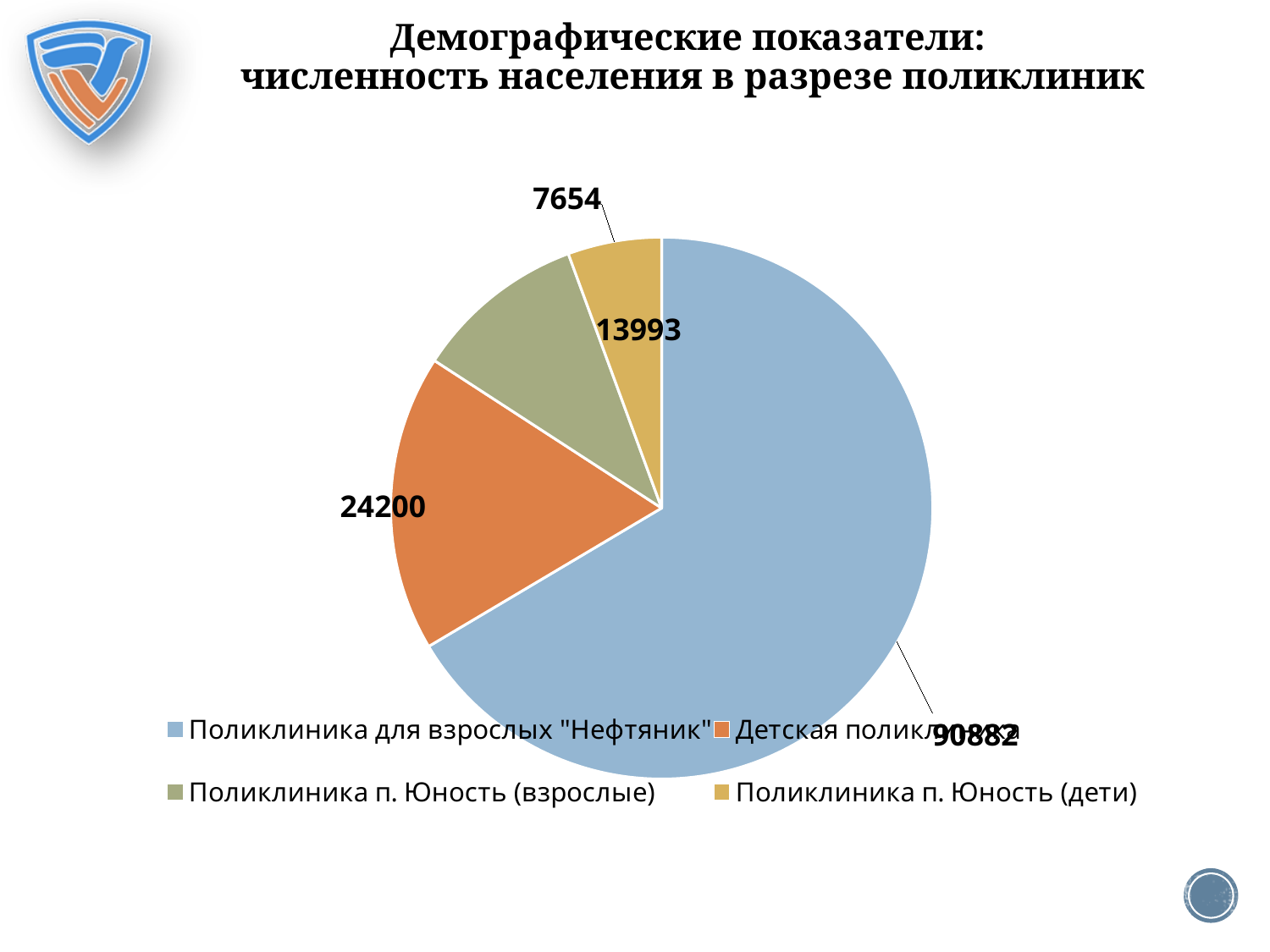
What is the value for Поликлиника п. Юность (взрослые)? 13993 What colour is the slice for Поликлиника п. Юность (дети)? yellow What is the value for Поликлиника для взрослых "Нефтяник"? 90882 Which is larger: Поликлиника п. Юность (взрослые) or Поликлиника п. Юность (дети)? Поликлиника п. Юность (взрослые) What is the value of the orange slice? 24200 What is the difference between Поликлиника п. Юность (взрослые) and Поликлиника п. Юность (дети)? 6339 What kind of chart is shown on the slide? pie chart How many slices does the pie chart have? 4 Which category has the smallest slice? Поликлиника п. Юность (дети) What is the value for Поликлиника п. Юность (дети)? 7654 What is the difference between Поликлиника для взрослых "Нефтяник" and the orange slice (24200)? 66682 Which category has the largest slice? Поликлиника для взрослых "Нефтяник"